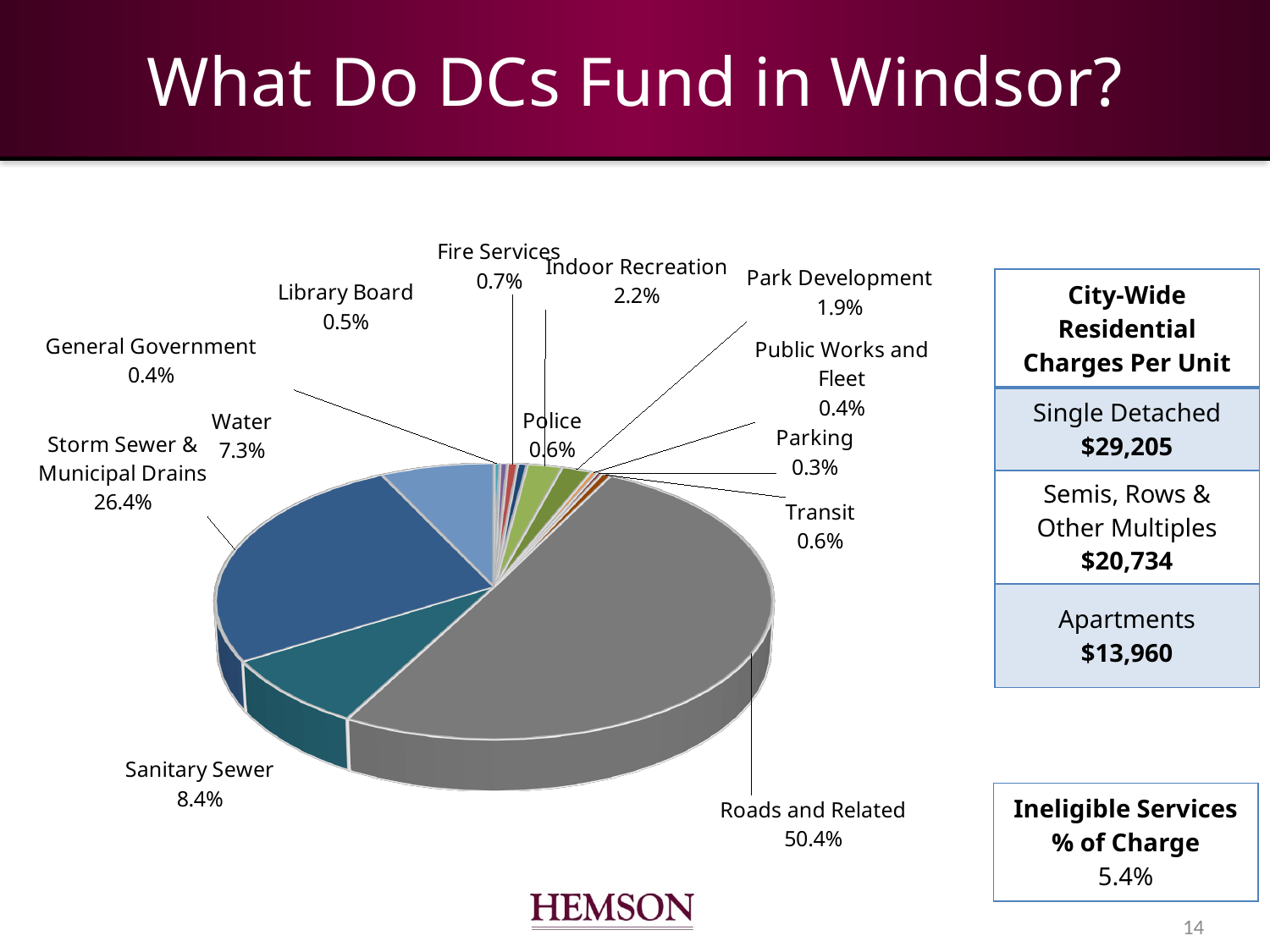
What is the title of the slide containing the pie chart? What Do DCs Fund in Windsor? What type of chart is shown on the slide? Pie chart What share of the pie does Roads and Related account for? 50.4% How many categories are shown in the pie chart? 13 What is the value for Storm Sewer & Municipal Drains? 26.4% Which is larger, the share for Sanitary Sewer or the share for Water? Sanitary Sewer Which category has the largest share of the pie? Roads and Related What is the value for Sanitary Sewer? 8.4% What is the value for Water? 7.3% Which category has the smallest share of the pie? Parking What is the difference between the shares for Roads and Related and Storm Sewer & Municipal Drains? 24.0% What is the value for Indoor Recreation? 2.2%